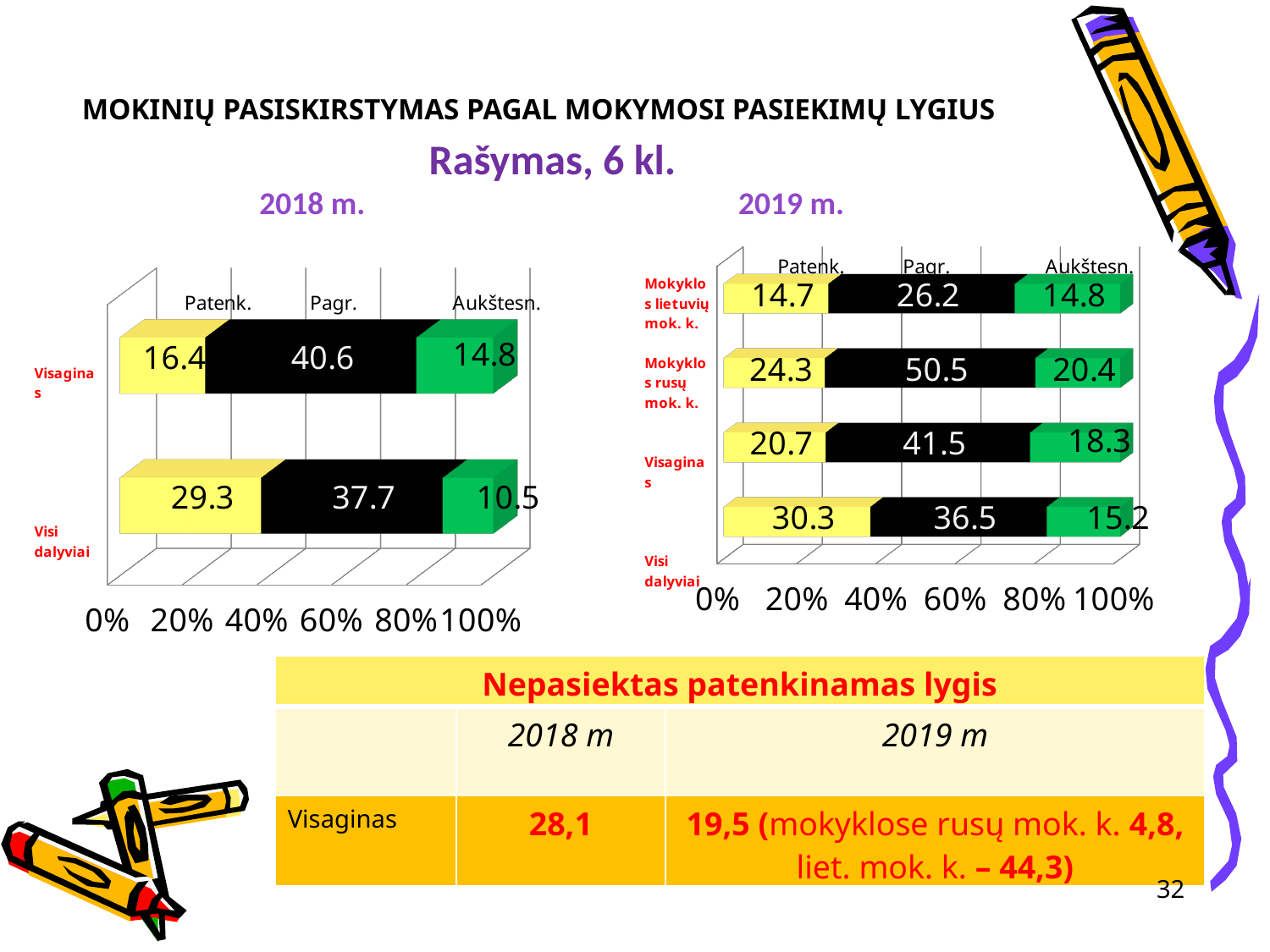
What type of chart is the 2018 m. chart? Stacked bar chart How many series does the 2018 m. chart show? 3 In the 2019 m. chart, what is the total of the stacked bar for Mokyklos lietuvių mok. k.? 55.7 In the 2019 m. chart, which category has the lowest Patenk. value? Mokyklos lietuvių mok. k. In the 2019 m. chart, which category has the highest Pagr. value? Mokyklos rusų mok. k. In the 2018 m. chart, what is the Patenk. value for Visi dalyviai? 29.3 In the 2018 m. chart, what is the difference between the Aukštesn. values for Visaginas and Visi dalyviai? 4.3 In the 2019 m. chart, what is the Aukštesn. value for Visaginas? 18.3 In the 2018 m. chart, what is the Pagr. value for Visaginas? 40.6 In the 2019 m. chart, what is the Pagr. value for Mokyklos rusų mok. k.? 50.5 In the 2019 m. chart, which is larger: the Patenk. value for Visi dalyviai or for Visaginas? Visi dalyviai How many categories are shown in the 2019 m. chart? 4